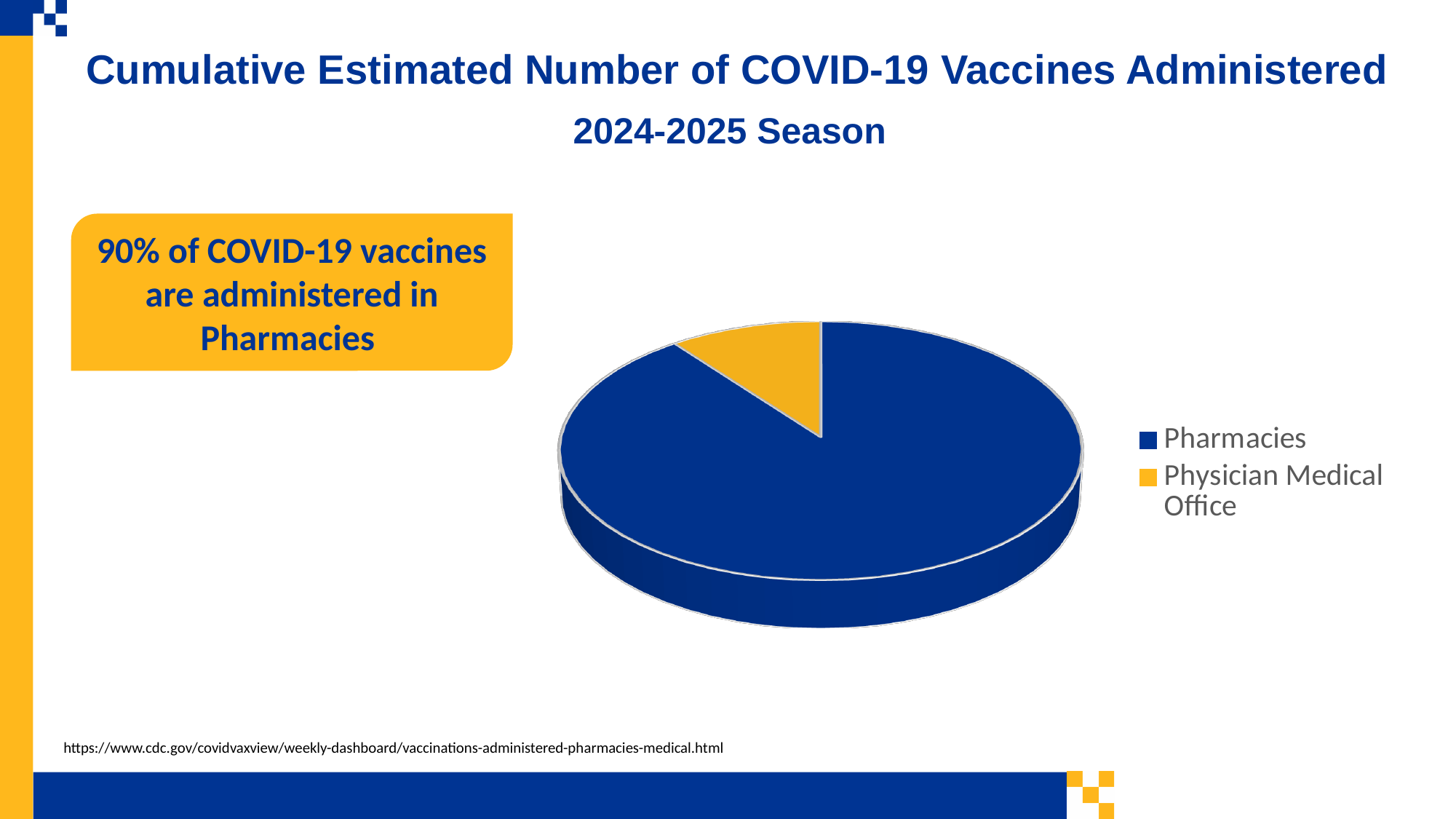
How many entries does the legend of the pie chart list? 2 What colour is the Physician Medical Office slice in the pie chart? yellow What kind of chart is shown on the slide? pie chart According to the callout on the slide, what share of COVID-19 vaccines are administered in Pharmacies? 90% Which slice is larger, Pharmacies or Physician Medical Office? Pharmacies How many slices does the pie chart have? 2 What is the title of the chart on the slide? Cumulative Estimated Number of COVID-19 Vaccines Administered 2024-2025 Season Which category has the smallest slice of the pie chart? Physician Medical Office Which category has the largest slice of the pie chart? Pharmacies